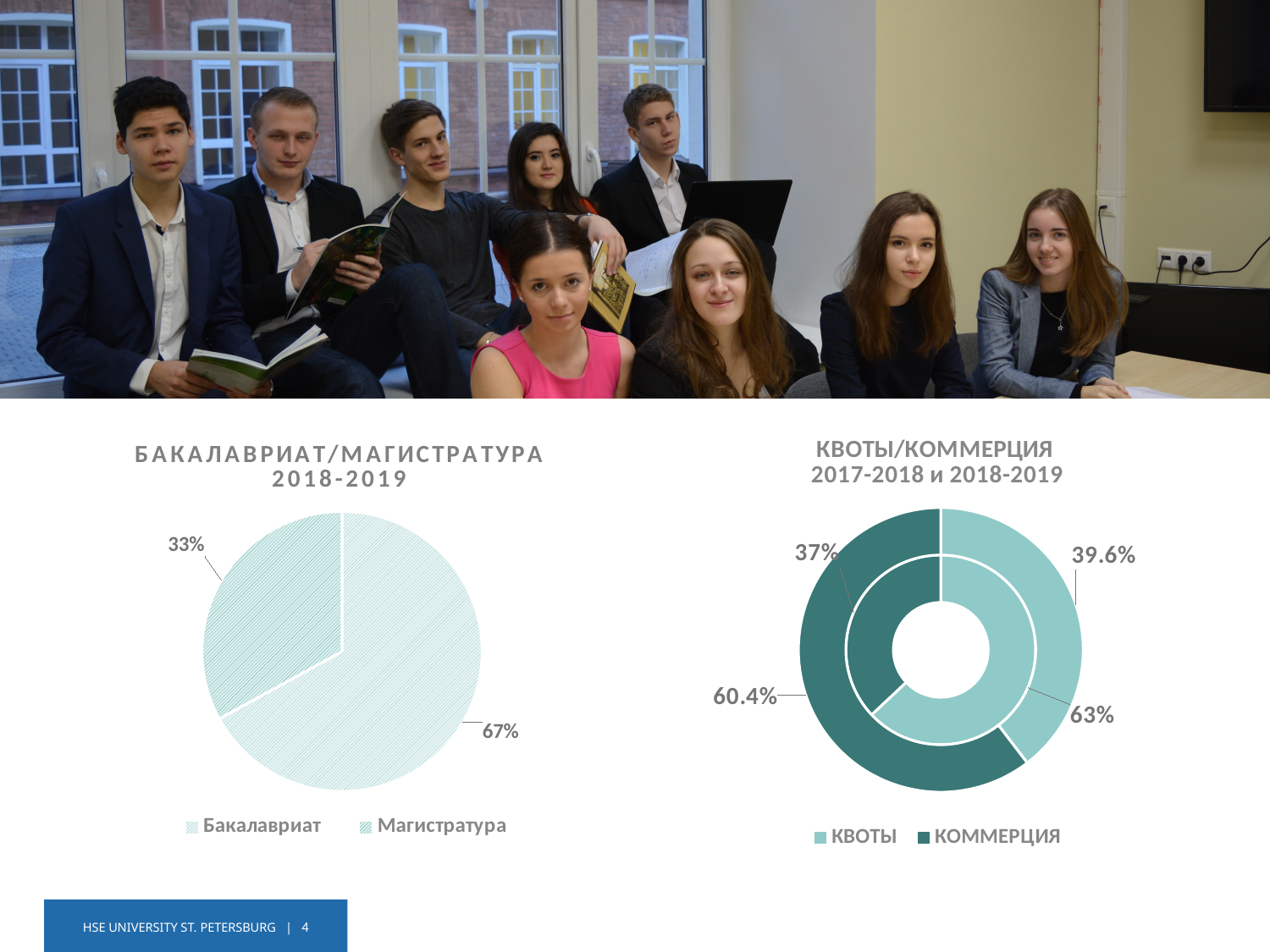
How many categories does the legend of the chart titled 'БАКАЛАВРИАТ/МАГИСТРАТУРА 2018-2019' list? 2 What kind of chart is the one titled 'КВОТЫ/КОММЕРЦИЯ 2017-2018 и 2018-2019'? Doughnut chart In the chart titled 'КВОТЫ/КОММЕРЦИЯ 2017-2018 и 2018-2019', what share does КОММЕРЦИЯ have in the outer ring? 60.4% In the chart titled 'БАКАЛАВРИАТ/МАГИСТРАТУРА 2018-2019', what share does Магистратура have? 33% In the chart titled 'КВОТЫ/КОММЕРЦИЯ 2017-2018 и 2018-2019', what share does КОММЕРЦИЯ have in the inner ring? 37% In the chart titled 'КВОТЫ/КОММЕРЦИЯ 2017-2018 и 2018-2019', which category has the larger share in the outer ring? КОММЕРЦИЯ In the chart titled 'БАКАЛАВРИАТ/МАГИСТРАТУРА 2018-2019', which category has the larger share? Бакалавриат In the chart titled 'БАКАЛАВРИАТ/МАГИСТРАТУРА 2018-2019', what is the difference in percentage points between Бакалавриат and Магистратура? 34 In the chart titled 'КВОТЫ/КОММЕРЦИЯ 2017-2018 и 2018-2019', which category is shown in the darker teal colour? КОММЕРЦИЯ What kind of chart is the one titled 'БАКАЛАВРИАТ/МАГИСТРАТУРА 2018-2019'? Pie chart